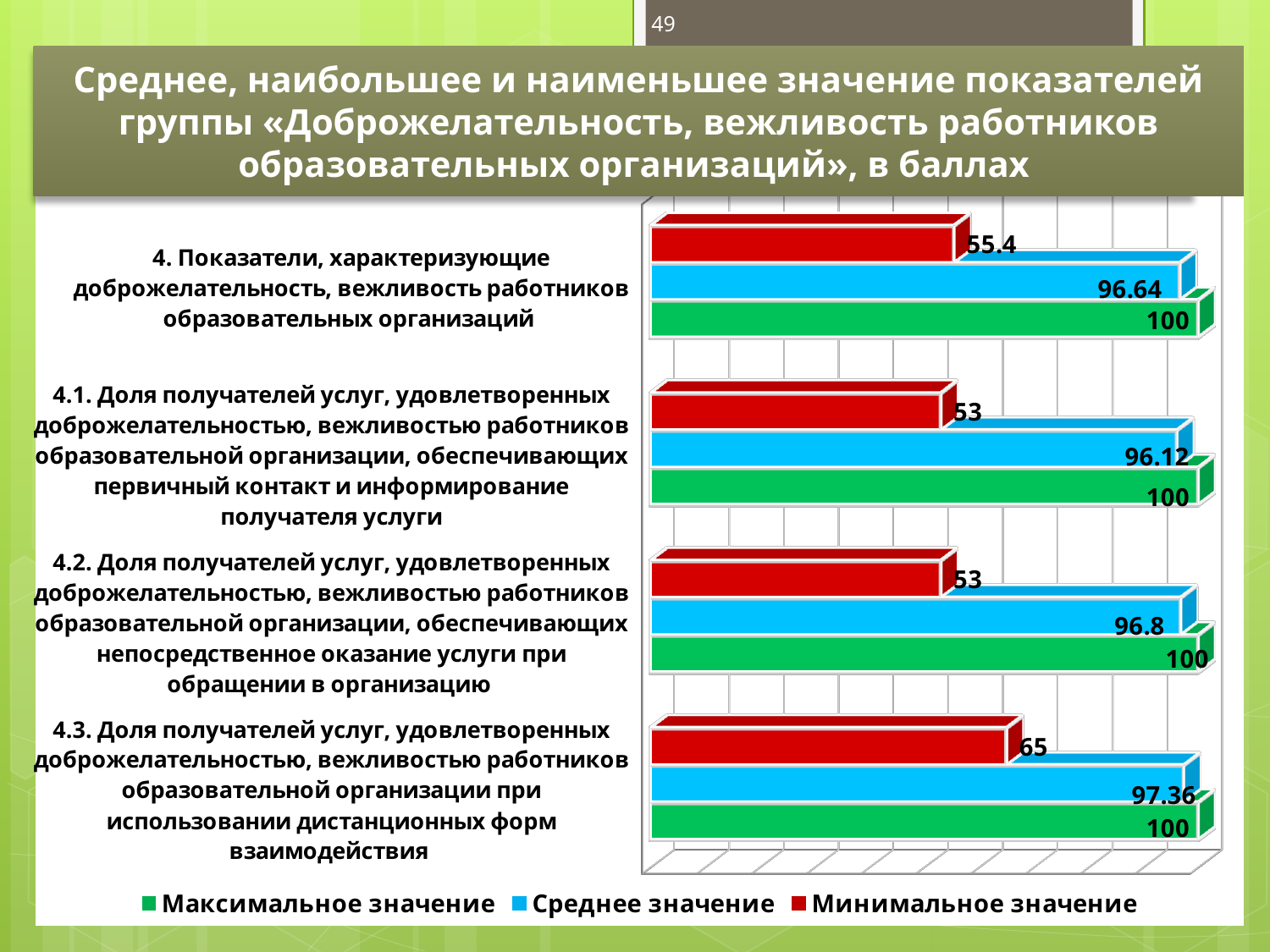
Какова разница между максимальным и средним значением показателя 4.2? 3.2 Сколько рядов данных перечислено в легенде диаграммы? 3 У какого показателя самое высокое минимальное значение? 4.3 У какого показателя самое высокое среднее значение? 4.3 Какое среднее значение показателя 4 (показатели, характеризующие доброжелательность, вежливость работников)? 96.64 На сколько баллов минимальное значение показателя 4.3 больше минимального значения показателя 4.1? 12 Какого цвета ряд «Минимальное значение» на диаграмме? Красного Какое максимальное значение показателя 4.2 (непосредственное оказание услуги при обращении в организацию)? 100 Что больше: среднее значение показателя 4 или среднее значение показателя 4.2? Среднее значение показателя 4.2 Какое среднее значение показателя 4.1 (первичный контакт и информирование получателя услуги)? 96.12 Какое минимальное значение показателя 4.3 (при использовании дистанционных форм взаимодействия)? 65 Сколько показателей (категорий) представлено на диаграмме? 4